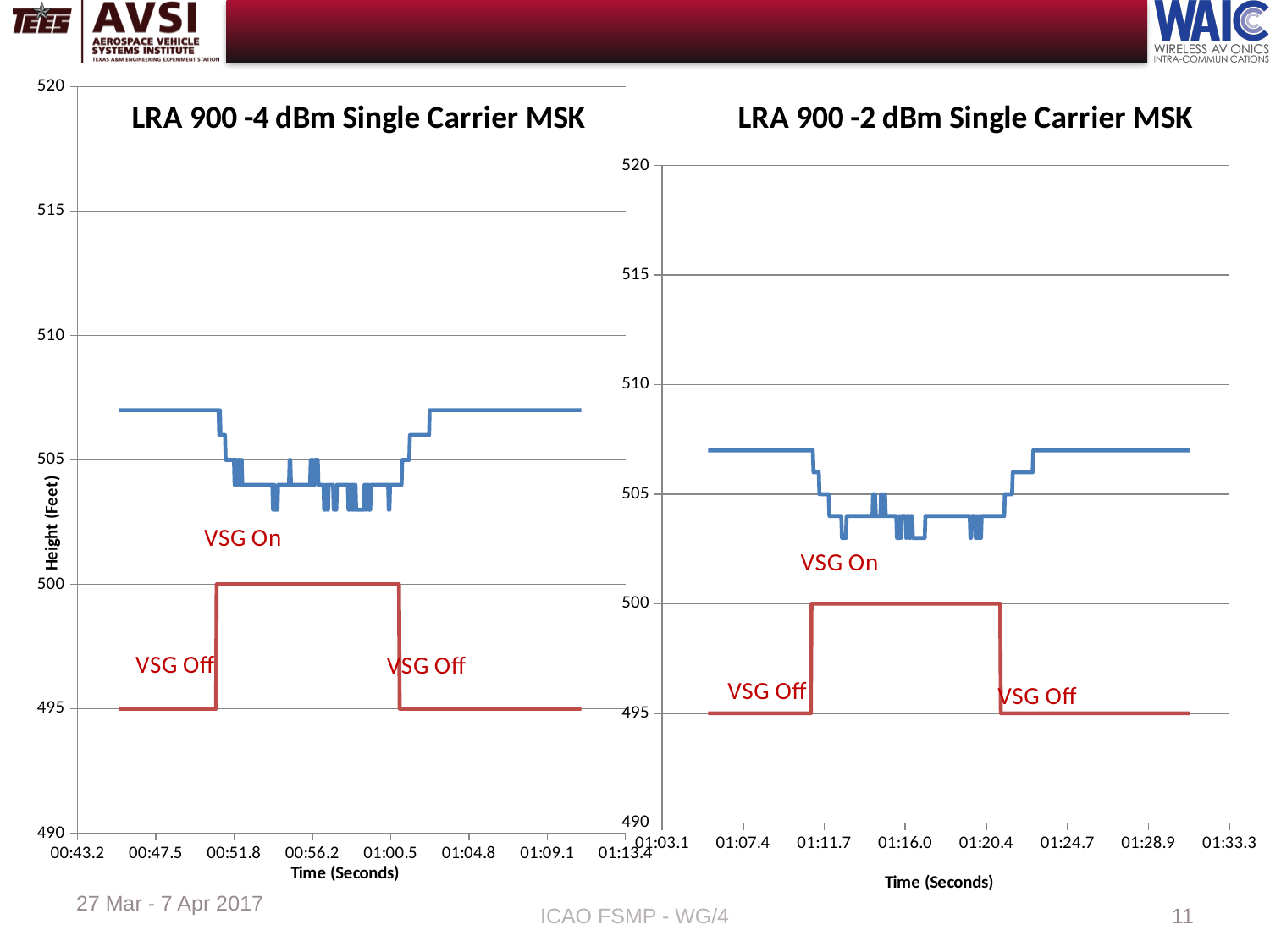
How many tick labels are shown on the x axis of the 'LRA 900 -2 dBm Single Carrier MSK' chart? 8 What is the title of the chart on the right side of the slide? LRA 900 -2 dBm Single Carrier MSK On the left chart, what is the label of the vertical axis? Height (Feet) On the 'LRA 900 -2 dBm Single Carrier MSK' chart, what value does the red line sit at during the 'VSG Off' periods? 495 What kind of chart is the 'LRA 900 -4 dBm Single Carrier MSK' chart on the left? line chart On the 'LRA 900 -2 dBm Single Carrier MSK' chart, does the blue height line rise or fall after the VSG is switched off at the end of the 'VSG On' period? rise On the 'LRA 900 -4 dBm Single Carrier MSK' chart, what value does the red line sit at during the 'VSG On' period? 500 On the 'LRA 900 -4 dBm Single Carrier MSK' chart, what is the first time label on the x axis? 00:43.2 On the 'LRA 900 -4 dBm Single Carrier MSK' chart, does the blue height line fall or rise when the VSG is switched on? fall On the 'LRA 900 -2 dBm Single Carrier MSK' chart, what is the maximum value shown on the vertical axis? 520 On the 'LRA 900 -2 dBm Single Carrier MSK' chart, is the blue height line during the 'VSG On' period greater or less than 505? less On the 'LRA 900 -4 dBm Single Carrier MSK' chart, is the blue height line at the start of the trace greater or less than 505? greater